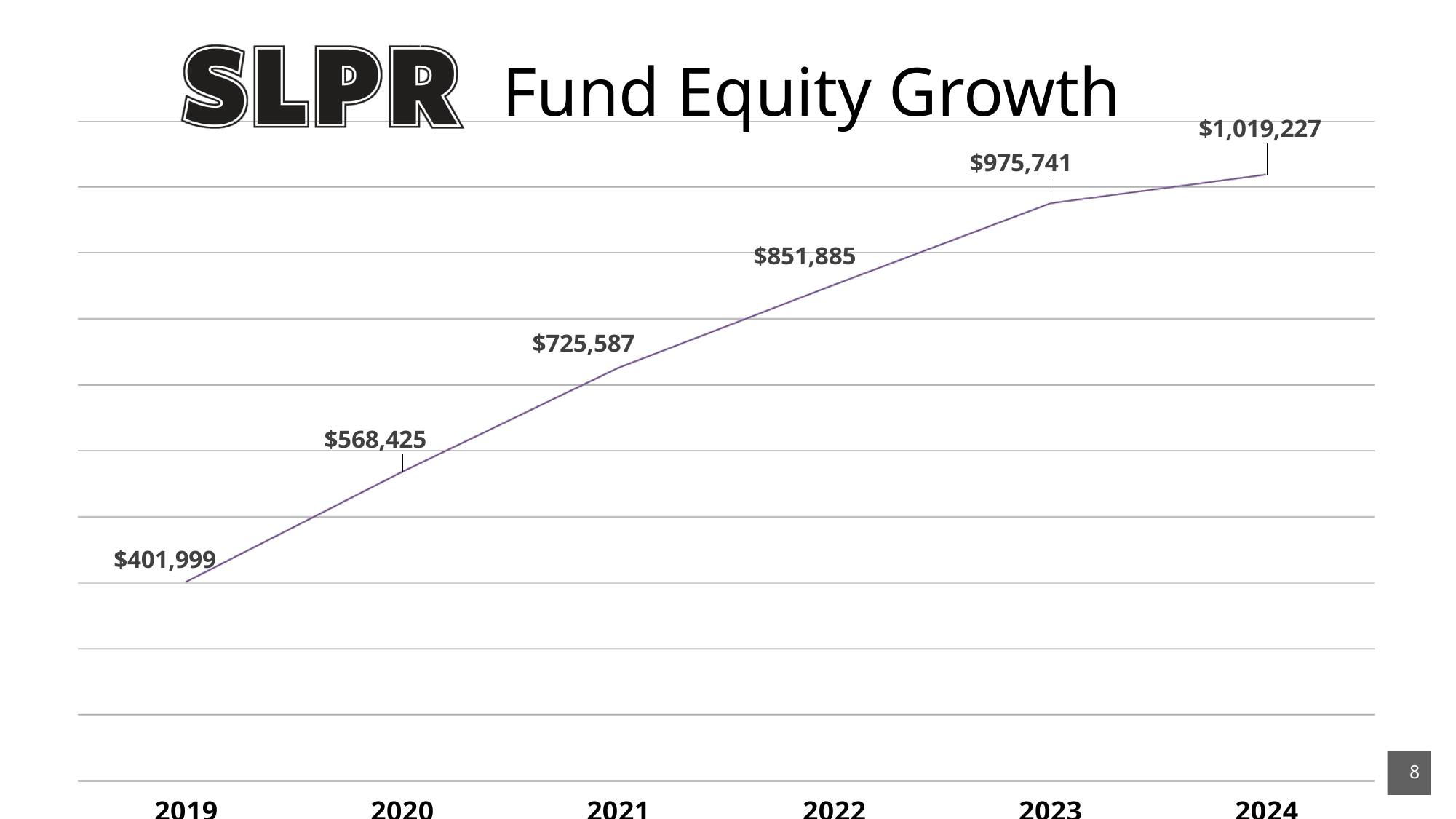
What is the difference between the fund equity values for 2020 and 2019? $166,426 Which year has the lowest fund equity value? 2019 Which year has the highest fund equity value? 2024 Which year has a larger fund equity value, 2022 or 2021? 2022 How many years are plotted on the chart? 6 What kind of chart is shown on the slide? line chart Do the fund equity values rise or fall from 2019 to 2024? rise What is the fund equity value for 2019? $401,999 What is the fund equity value for 2023? $975,741 What is the fund equity value for 2021? $725,587 What is the difference between the fund equity values for 2024 and 2023? $43,486 What is the fund equity value for 2024? $1,019,227